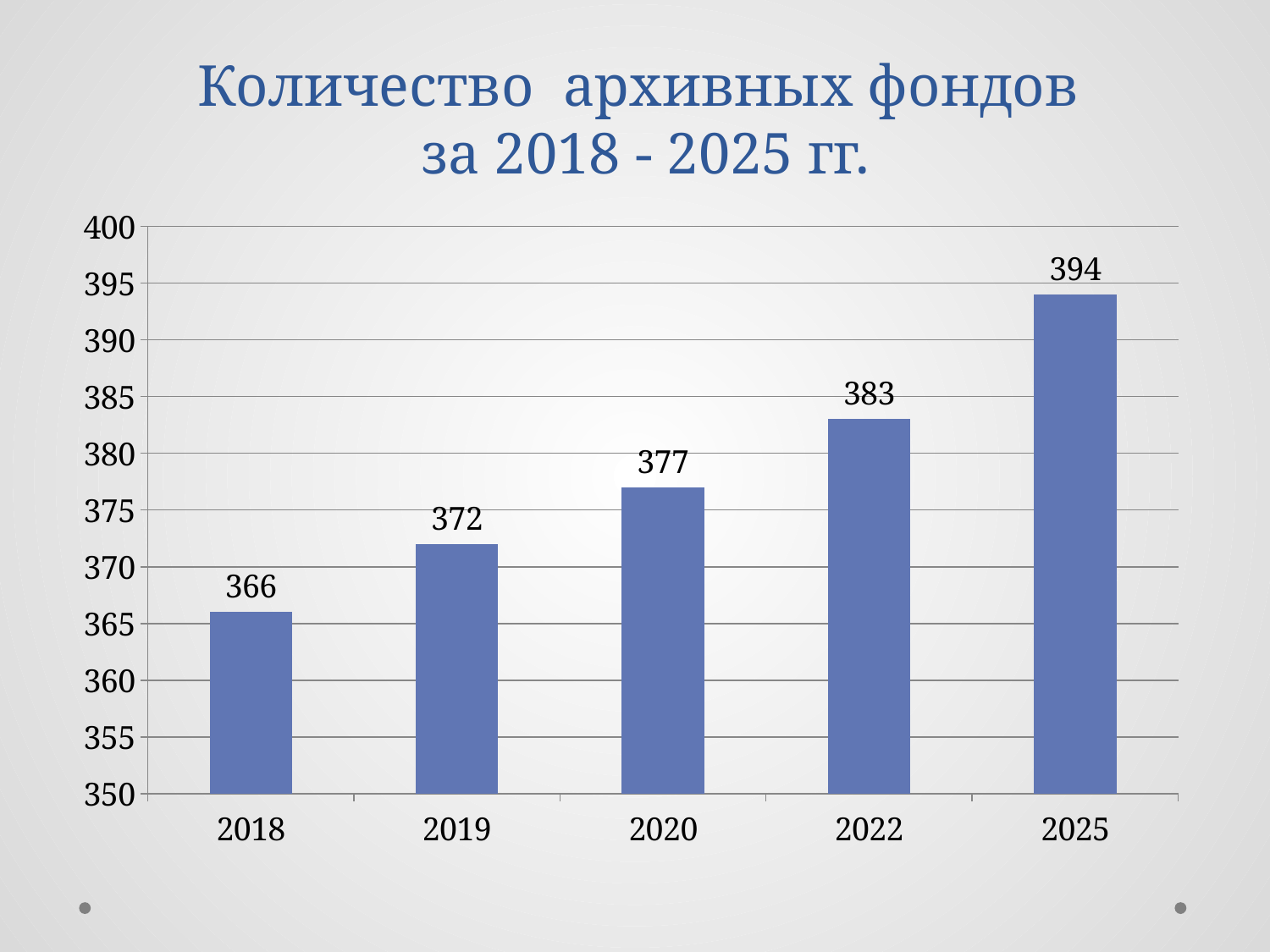
Which year has the highest value? 2025 What kind of chart is this? bar chart How many years are shown on the x axis? 5 Do the values rise or fall from 2018 to 2025? rise Is the value for 2020 greater or less than 375? greater Which is larger, the value for 2019 or the value for 2022? 2022 Which year has the lowest value? 2018 What is the difference between the values for 2022 and 2019? 11 What is the value for 2018? 366 What is the difference between the values for 2025 and 2018? 28 What is the value for 2025? 394 What is the value for 2020? 377